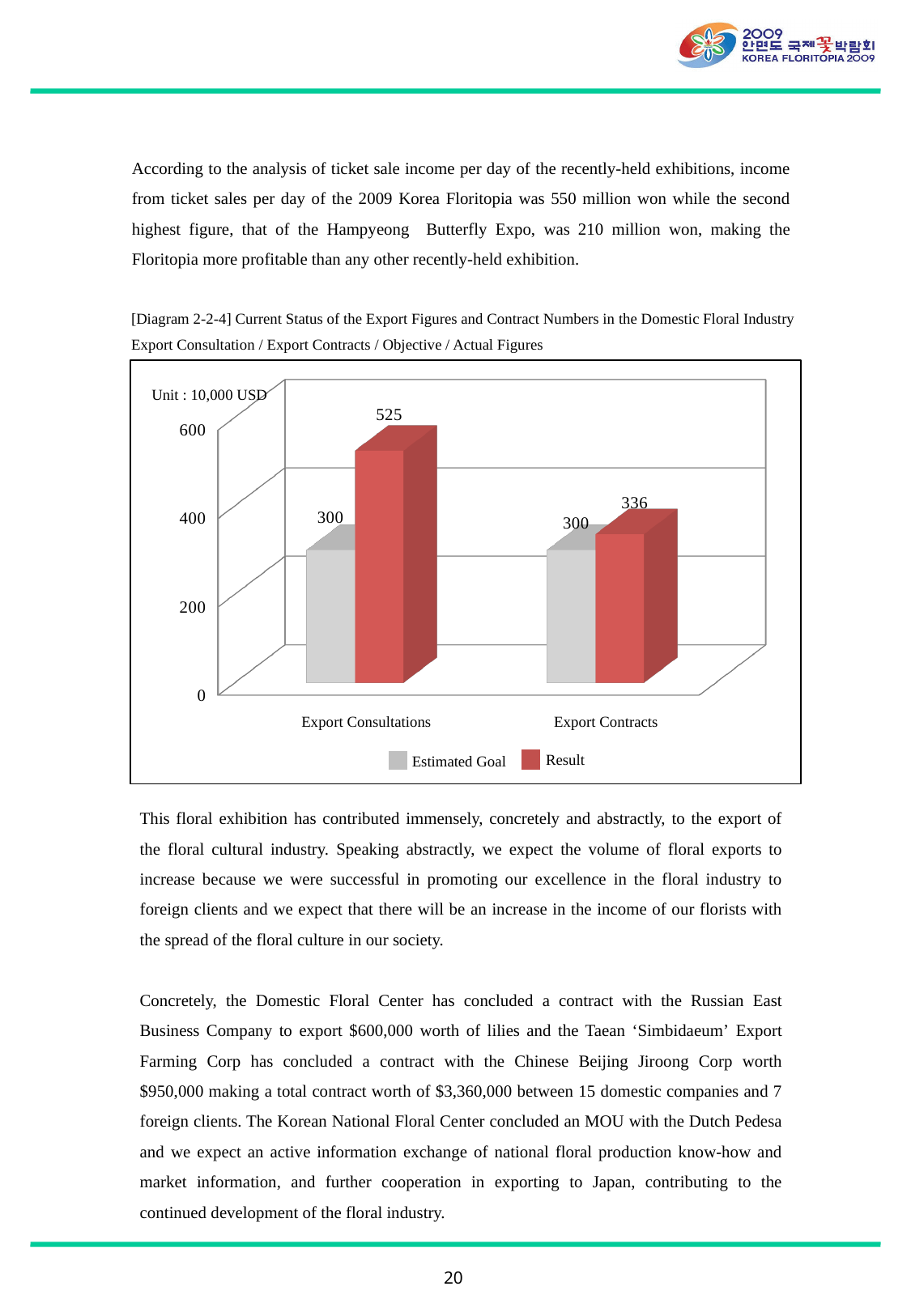
What is the Estimated Goal value for Export Contracts? 300 What is the Estimated Goal value for Export Consultations? 300 What is the difference between the Result and the Estimated Goal for Export Contracts? 36 What is the Result value for Export Consultations? 525 What is the difference between the Result and the Estimated Goal for Export Consultations? 225 Which is larger: the Result for Export Consultations or the Result for Export Contracts? Export Consultations Which category has the highest Result value? Export Consultations What is the Result value for Export Contracts? 336 How many series does the legend list? 2 How many categories are shown on the x axis? 2 What kind of chart is shown? Bar chart What unit is stated for the values in the chart? 10,000 USD